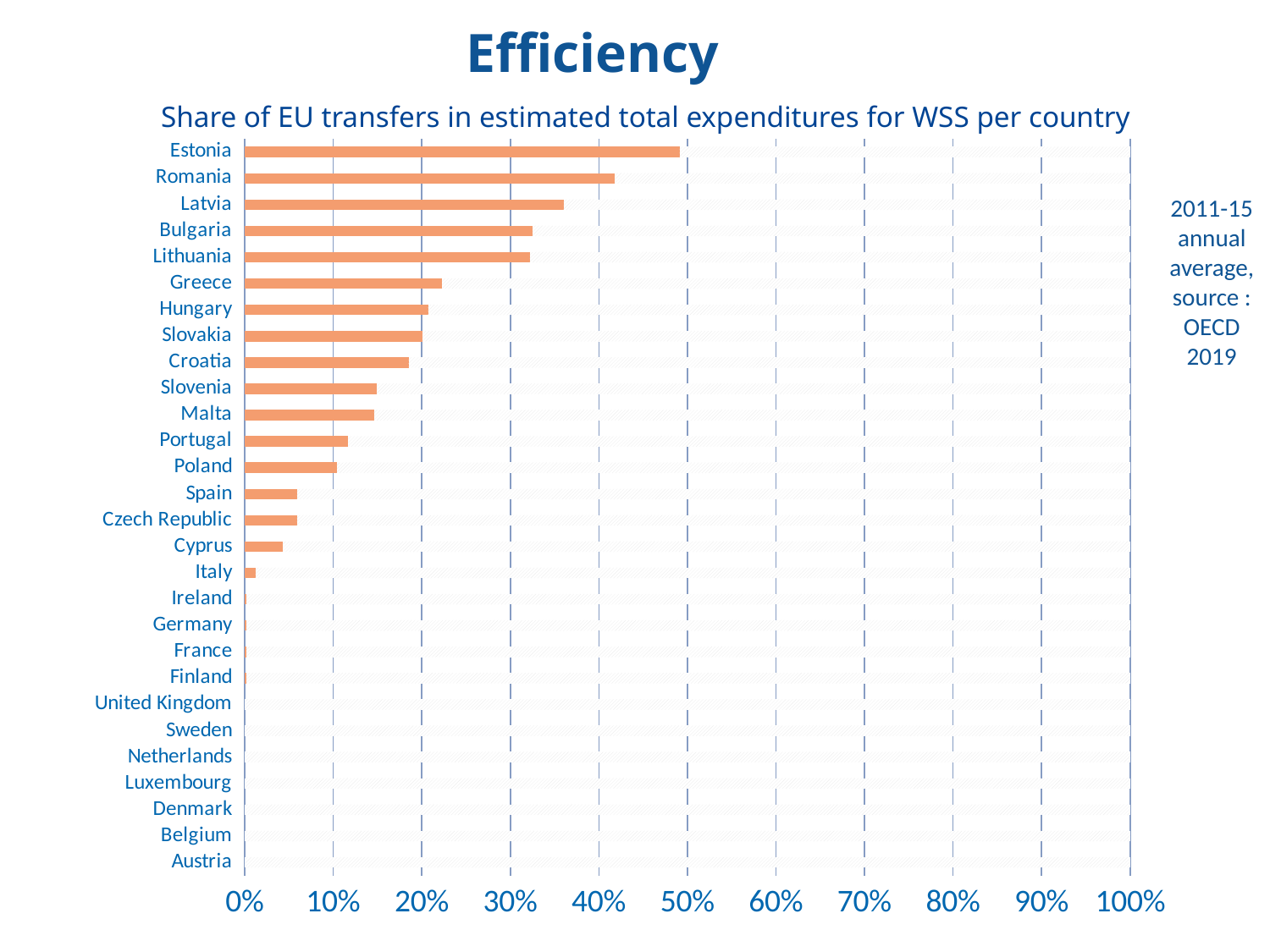
Which has a larger share of EU transfers, Estonia or Romania? Estonia Which country has the highest share of EU transfers in estimated total expenditures for WSS? Estonia Is the value for Cyprus greater or less than 10%? less Is the value for Portugal greater or less than 10%? greater Is the value for Romania greater or less than 50%? less Which has a larger share of EU transfers, Greece or Croatia? Greece How many countries are listed on the chart? 28 What is the title of the chart? Share of EU transfers in estimated total expenditures for WSS per country What kind of chart is shown on the slide? bar chart